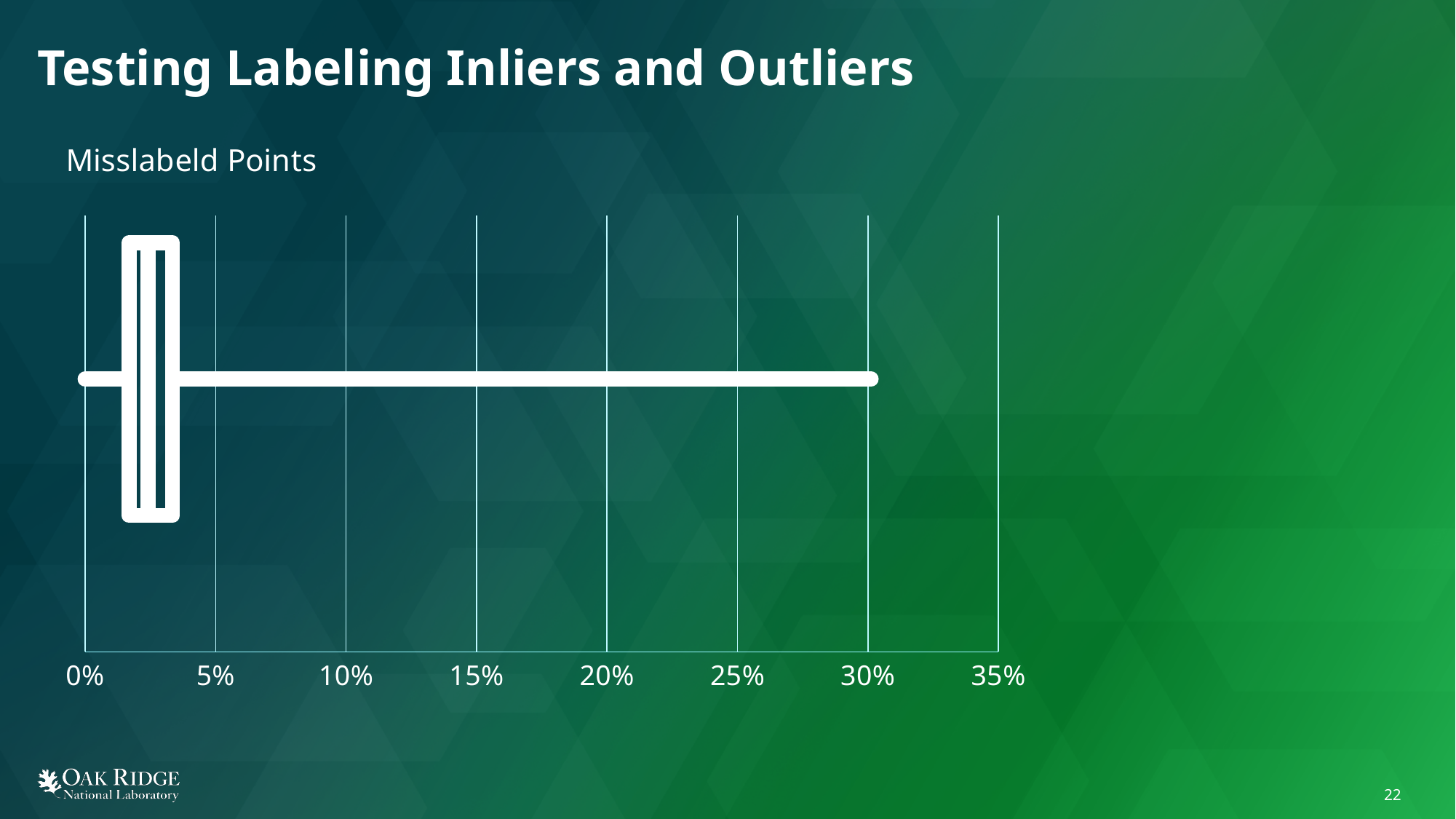
What is the title of the chart? Misslabeld Points What is the highest value labeled on the x axis? 35% How many boxes (data series) are plotted in the chart? 1 Is the right end of the whisker greater or less than 20%? greater What kind of chart is shown on the slide? Box-and-whisker plot Is the median line inside the box greater or less than 5%? less Is the left edge of the box greater or less than 0%? greater